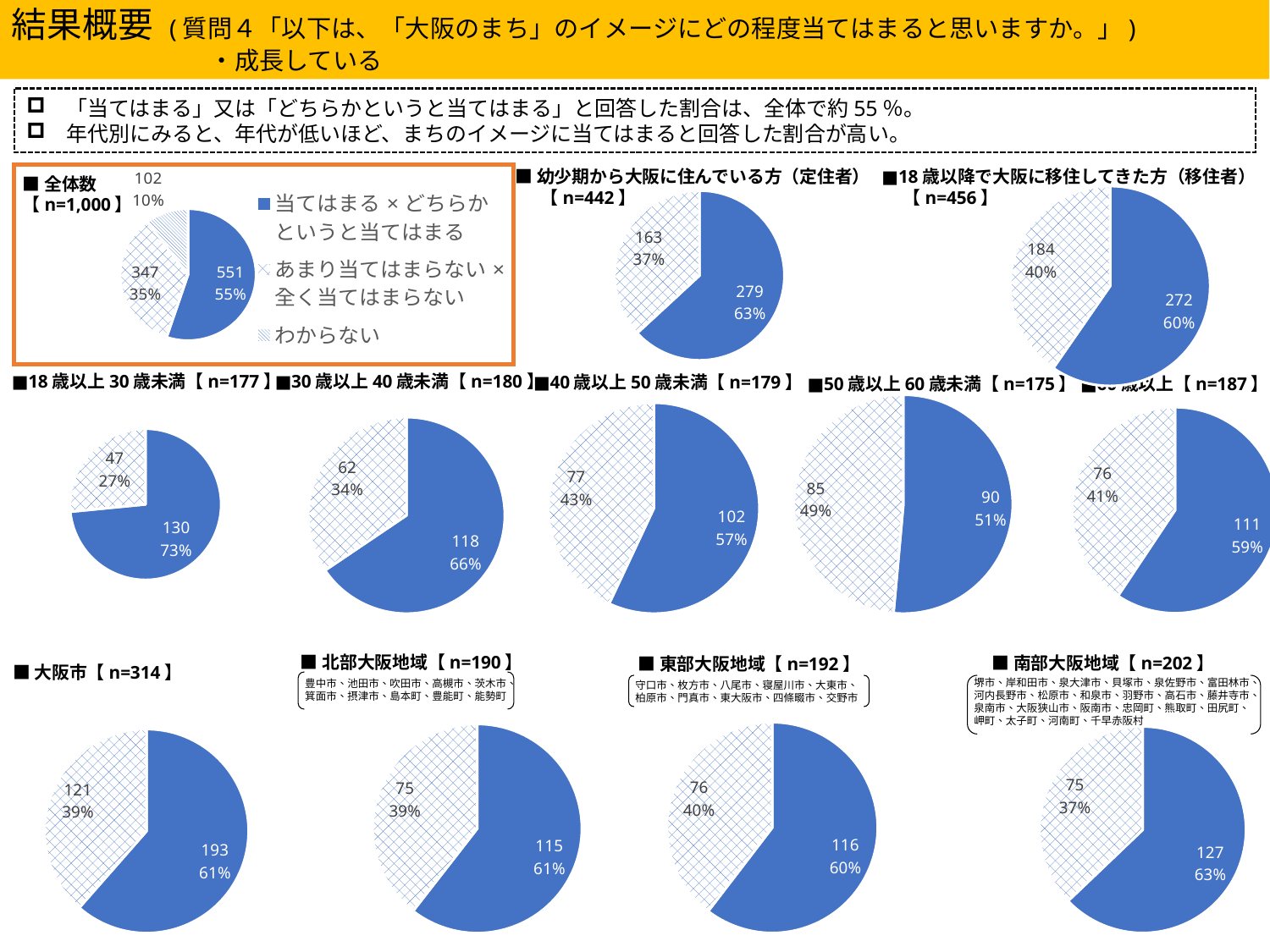
In the 全体数【n=1,000】pie chart, what share of the pie is わからない? 10% How many entries does the legend of the 全体数【n=1,000】pie chart list? 3 In the 幼少期から大阪に住んでいる方（定住者）【n=442】pie chart, what percentage is shown for the larger (solid blue) slice? 63% In the 18歳以降で大阪に移住してきた方（移住者）【n=456】pie chart, what is the count for the hatched (あまり当てはまらない × 全く当てはまらない) slice? 184 Among the five age-group pie charts, which age group has the lowest percentage for the solid blue (当てはまる) slice? 50歳以上60歳未満 In the 東部大阪地域【n=192】pie chart, what is the total of the two slice counts (116 and 76)? 192 Among the five age-group pie charts, which age group has the highest percentage for the solid blue (当てはまる) slice? 18歳以上30歳未満 Which has a larger solid blue (当てはまる) percentage: the 大阪市【n=314】pie chart or the 南部大阪地域【n=202】pie chart? 南部大阪地域 What type of chart is used for the 幼少期から大阪に住んでいる方（定住者）【n=442】data? Pie chart In the 18歳以上30歳未満【n=177】pie chart, what is the difference between the two slice counts (130 and 47)? 83 In the 全体数【n=1,000】pie chart, how many respondents answered 当てはまる × どちらかというと当てはまる? 551 In the 50歳以上60歳未満【n=175】pie chart, what is the count for the solid blue slice? 90